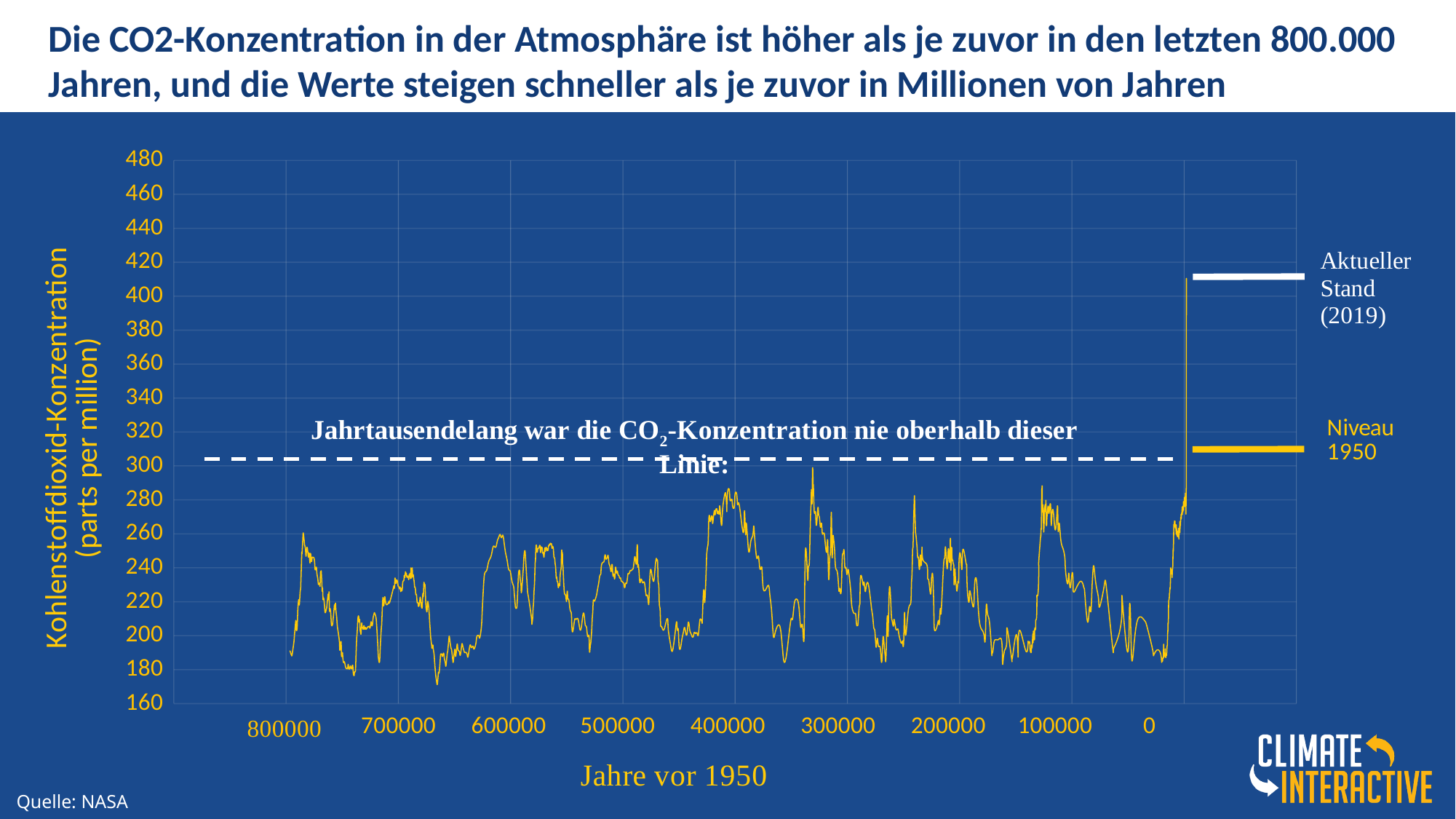
Is the lowest CO2 concentration shown on the chart greater or less than 160? greater What is the highest value shown on the y axis? 480 Is the value marked "Niveau 1950" greater or less than 300? greater What is the title of the x axis? Jahre vor 1950 Is the value marked "Aktueller Stand (2019)" greater or less than 400? greater Which is larger, the value marked "Aktueller Stand (2019)" or the value marked "Niveau 1950"? Aktueller Stand (2019) What kind of chart is shown on the slide? line chart How many tick labels are shown on the x axis? 9